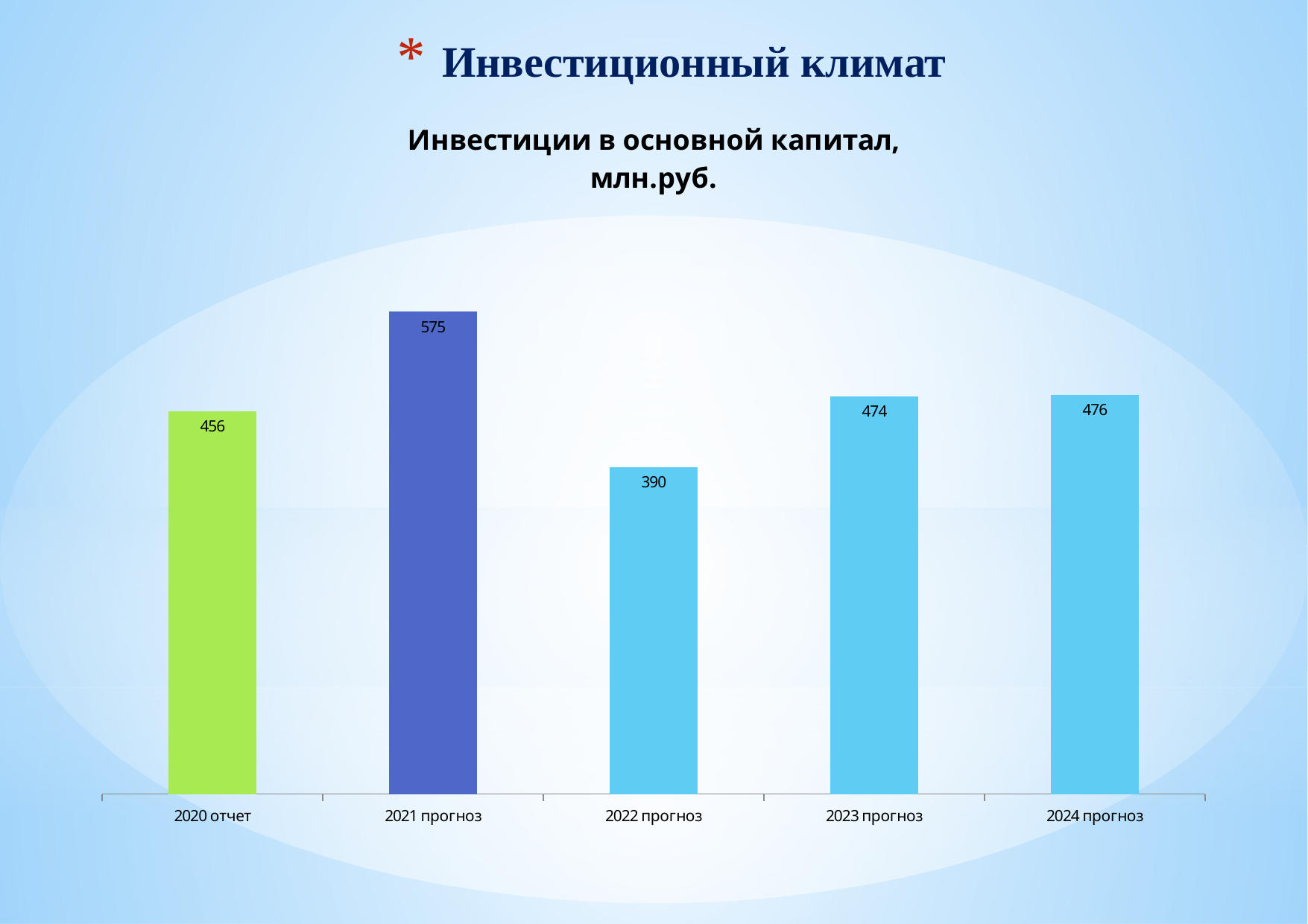
What is the difference between the values for 2023 прогноз and 2020 отчет? 18 What is the difference between the values for 2021 прогноз and 2022 прогноз? 185 Which category has the highest value? 2021 прогноз Which category has the lowest value? 2022 прогноз Which is larger, the value for 2020 отчет or the value for 2022 прогноз? 2020 отчет What kind of chart is shown on the slide? bar chart What is the title of the chart? Инвестиции в основной капитал, млн.руб. How many categories are shown on the x axis? 5 What is the value for 2022 прогноз? 390 What is the value for 2020 отчет? 456 What is the value for 2021 прогноз? 575 What is the value for 2024 прогноз? 476